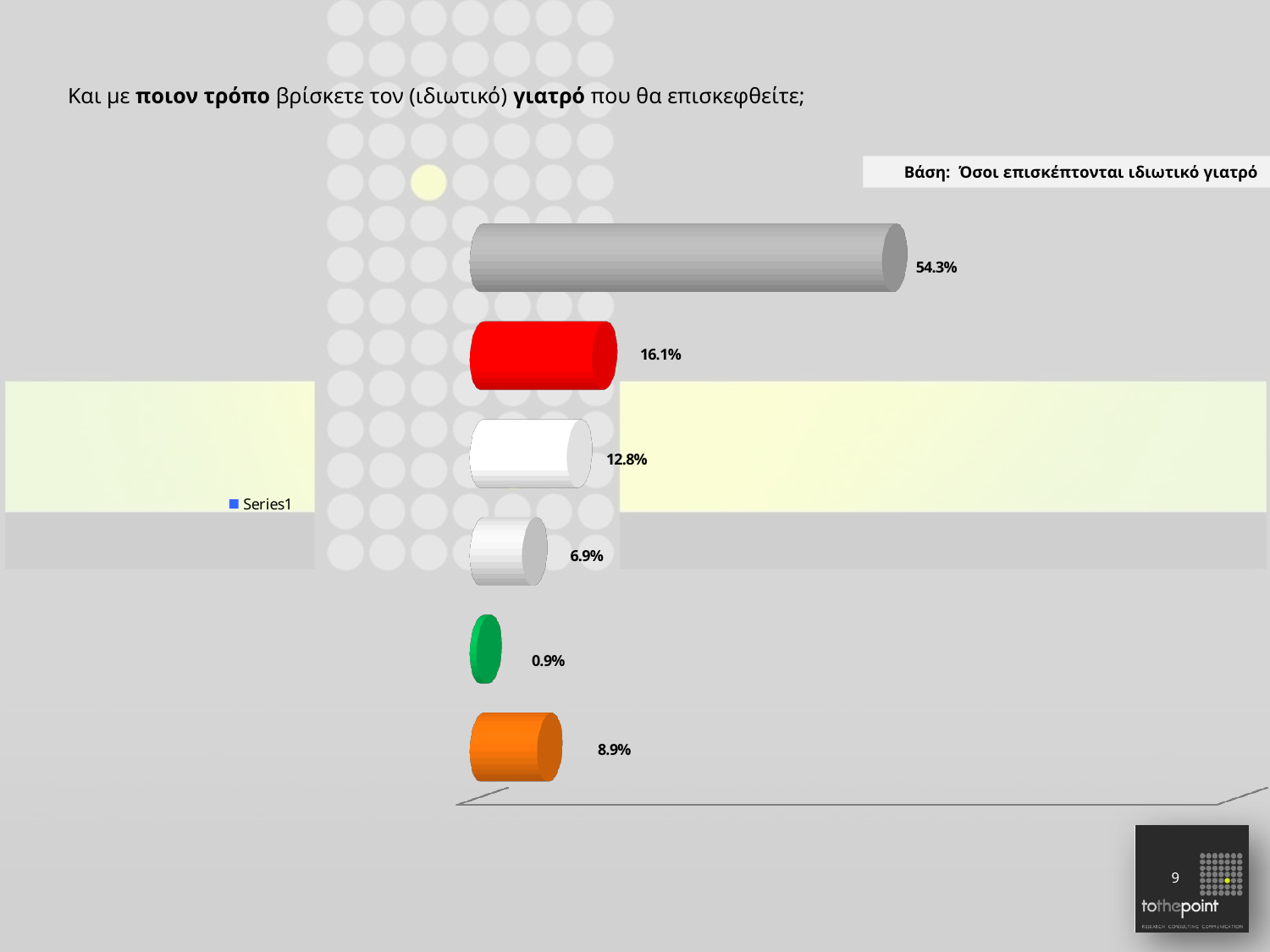
How many series does the legend list? 1 What is the highest value shown in the chart? 54.3% What is the value shown on the red bar? 16.1% What entry does the chart legend show? Series1 What is the value shown on the topmost (gray) bar? 54.3% Which is larger, the value of the white bar or the value of the orange bar? the white bar (12.8%) What is the value shown on the green bar? 0.9% What is the difference between the topmost bar (54.3%) and the red bar (16.1%)? 38.2% What is the lowest value shown in the chart? 0.9% How many bars does the chart contain? 6 What kind of chart is shown on the slide? bar chart What is the value shown on the orange bar at the bottom of the chart? 8.9%